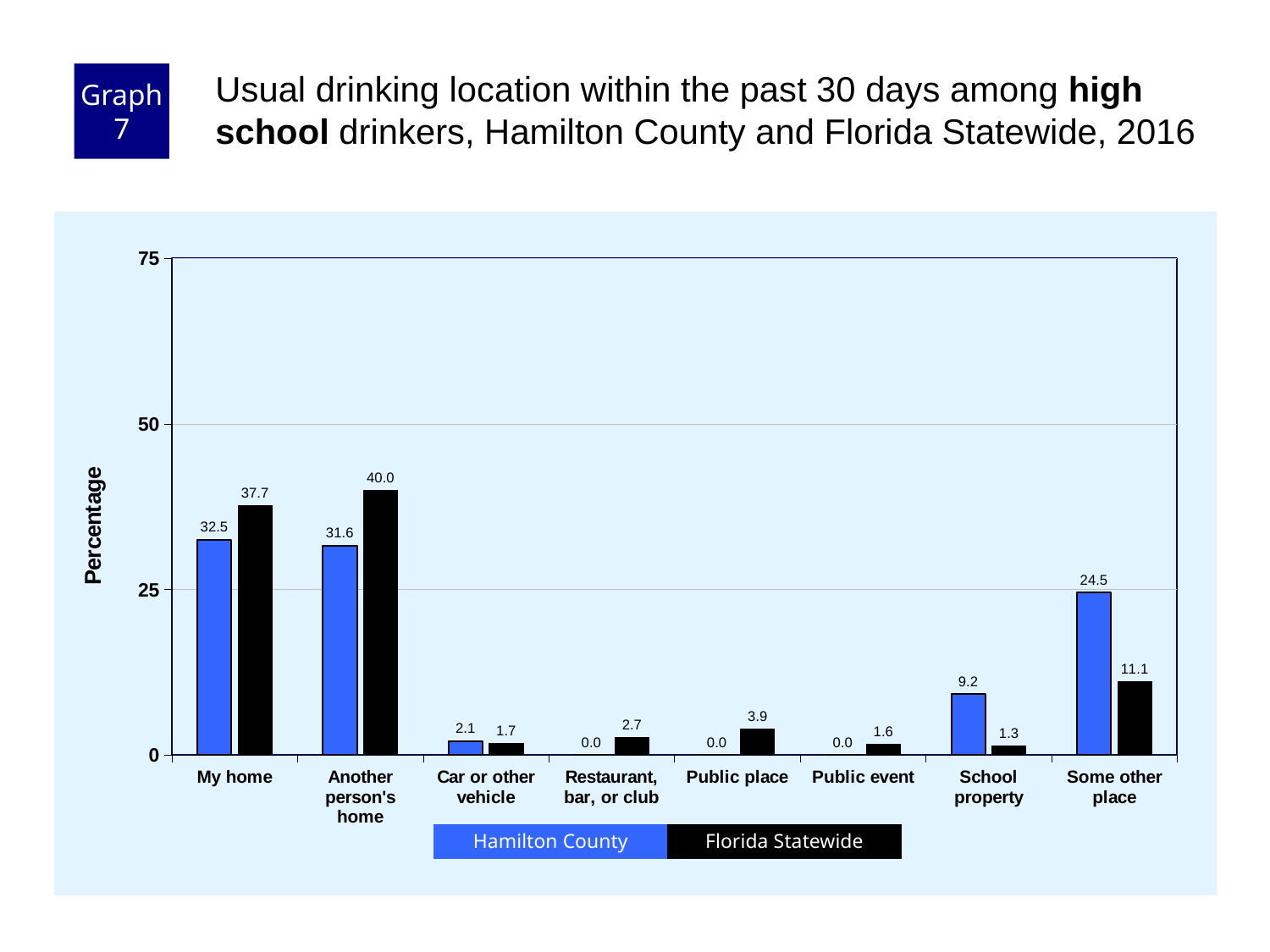
How many series does the legend list? 2 What is the difference between the Florida Statewide and Hamilton County values for My home? 5.2 What is the difference between the Hamilton County and Florida Statewide values for Some other place? 13.4 How many categories are shown on the x axis? 8 Which category has the highest Florida Statewide value? Another person's home What is the Hamilton County value for My home? 32.5 What kind of chart is shown? bar chart Which is larger for School property, Hamilton County or Florida Statewide? Hamilton County What is the Hamilton County value for Some other place? 24.5 Which category has the highest Hamilton County value? My home What is the Florida Statewide value for Another person's home? 40.0 Is the Florida Statewide value for Another person's home greater or less than 50? less